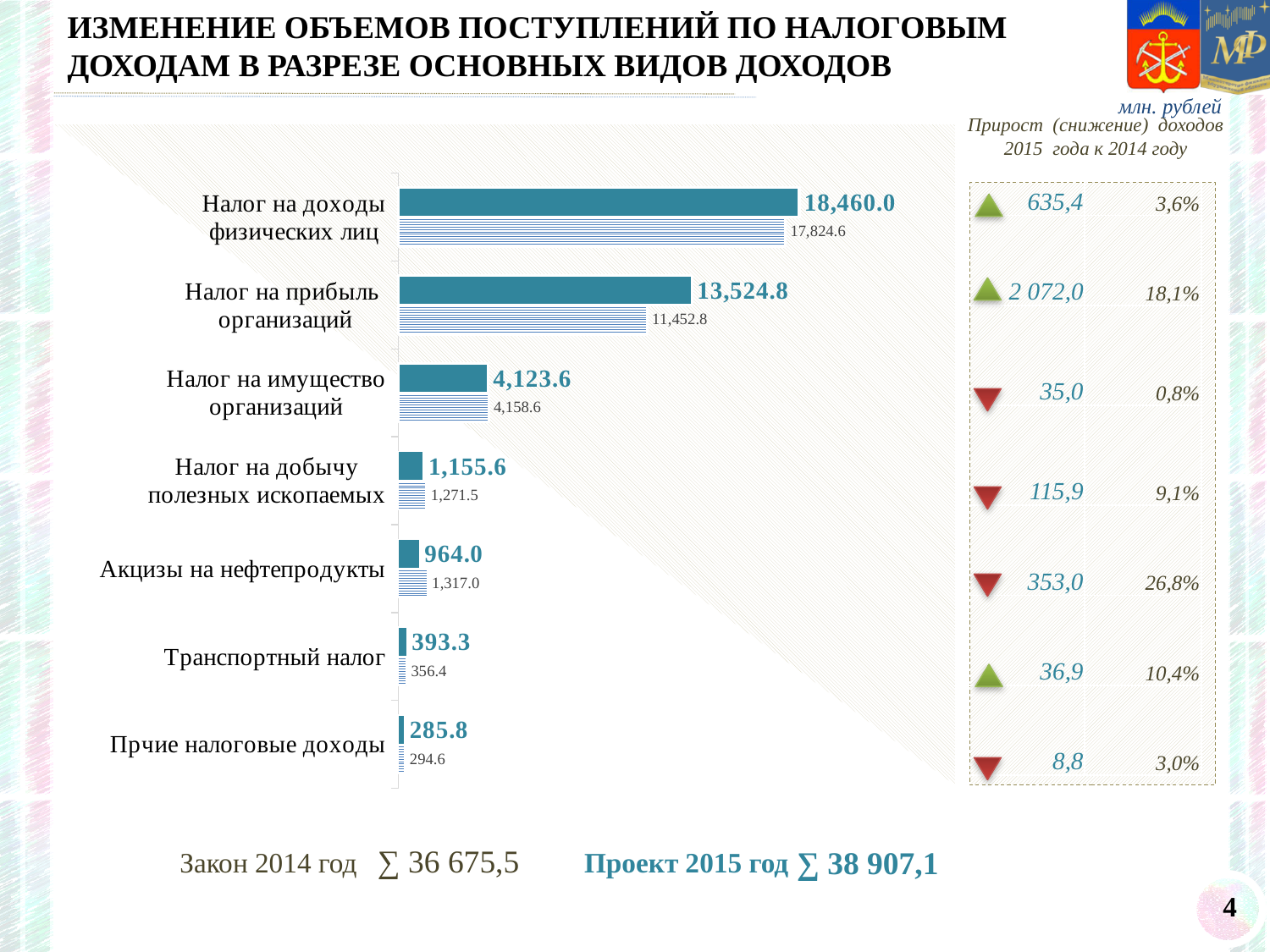
What unit of measurement is stated for the chart values? млн. рублей What type of chart is shown on the slide? bar chart What is the value shown in the smaller data label (striped bar) for Транспортный налог? 356.4 Which category has the lowest value among the solid (bold-labelled) bars? Прчие налоговые доходы What is the value shown in the smaller data label (striped bar) for Налог на прибыль организаций? 11,452.8 What is the value shown in the bold data label for Налог на доходы физических лиц? 18,460.0 For Акцизы на нефтепродукты, which is larger: the solid bar value (964.0) or the striped bar value (1,317.0)? the striped bar value (1,317.0) How many tax categories are plotted on the chart? 7 What is the difference between the bold-labelled value and the striped-bar value for Налог на прибыль организаций? 2,072.0 What is the difference between the solid bar value and the striped bar value for Налог на добычу полезных ископаемых? 115.9 Which category has the highest value among the solid (bold-labelled) bars? Налог на доходы физических лиц What is the value shown in the bold data label for Акцизы на нефтепродукты? 964.0